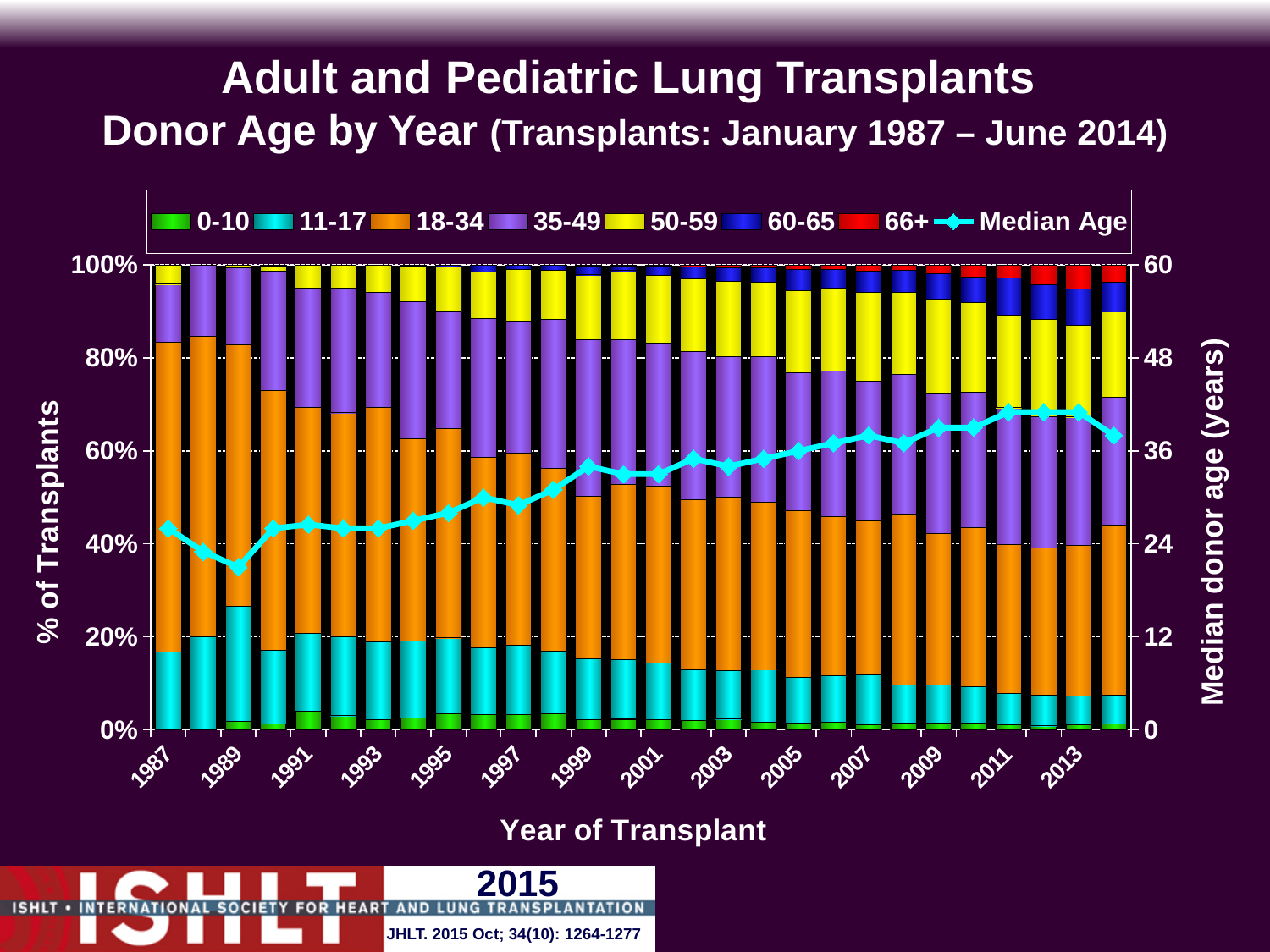
Which colour represents the 18-34 donor age group? Orange Is the median donor age in 2011 greater or less than 36 years? greater Is the median donor age in 1989 greater or less than 24 years? less Which year has the higher median donor age, 1987 or 2011? 2011 What kind of chart is shown on the slide? Stacked bar chart with a line for median age Which year has the lowest median donor age? 1989 Which year has the higher median donor age, 1989 or 1991? 1991 What is the label of the right-hand y axis? Median donor age (years) How many entries does the legend list? 8 Does the median donor age generally rise or fall from 1987 to 2013? Rise How many years (bars) are plotted along the x axis? 28 Is the median donor age in 1987 greater or less than 36 years? less